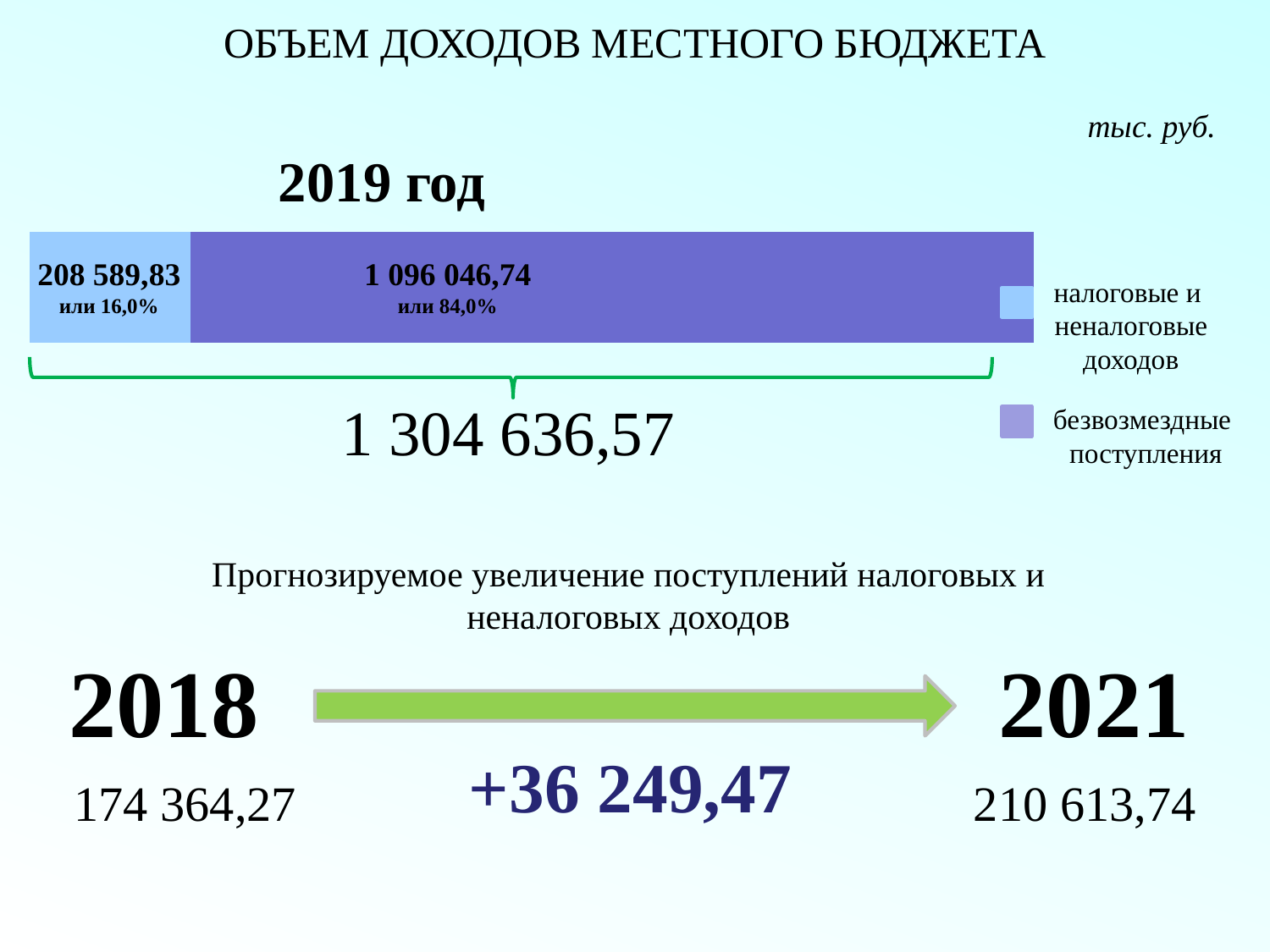
In what units are the values on the slide given? тыс. руб. Which segment of the 2019 bar is larger, 'налоговые и неналоговые доходов' or 'безвозмездные поступления'? безвозмездные поступления Which segment of the 2019 bar is the smallest? налоговые и неналоговые доходов How many series does the legend of the 2019 bar chart list? 2 What share of the 2019 bar do 'безвозмездные поступления' make up? 84,0% What kind of chart shows the 2019 budget revenues? stacked bar chart What is the title of the slide? ОБЪЕМ ДОХОДОВ МЕСТНОГО БЮДЖЕТА What is the total of the 2019 stacked bar? 1 304 636,57 What is the value of the 'безвозмездные поступления' segment in the 2019 bar? 1 096 046,74 What is the difference between the 'безвозмездные поступления' and 'налоговые и неналоговые доходов' segments in the 2019 bar? 887 456,91 What is the value of the 'налоговые и неналоговые доходов' segment in the 2019 bar? 208 589,83 What share of the 2019 bar do 'налоговые и неналоговые доходов' make up? 16,0%